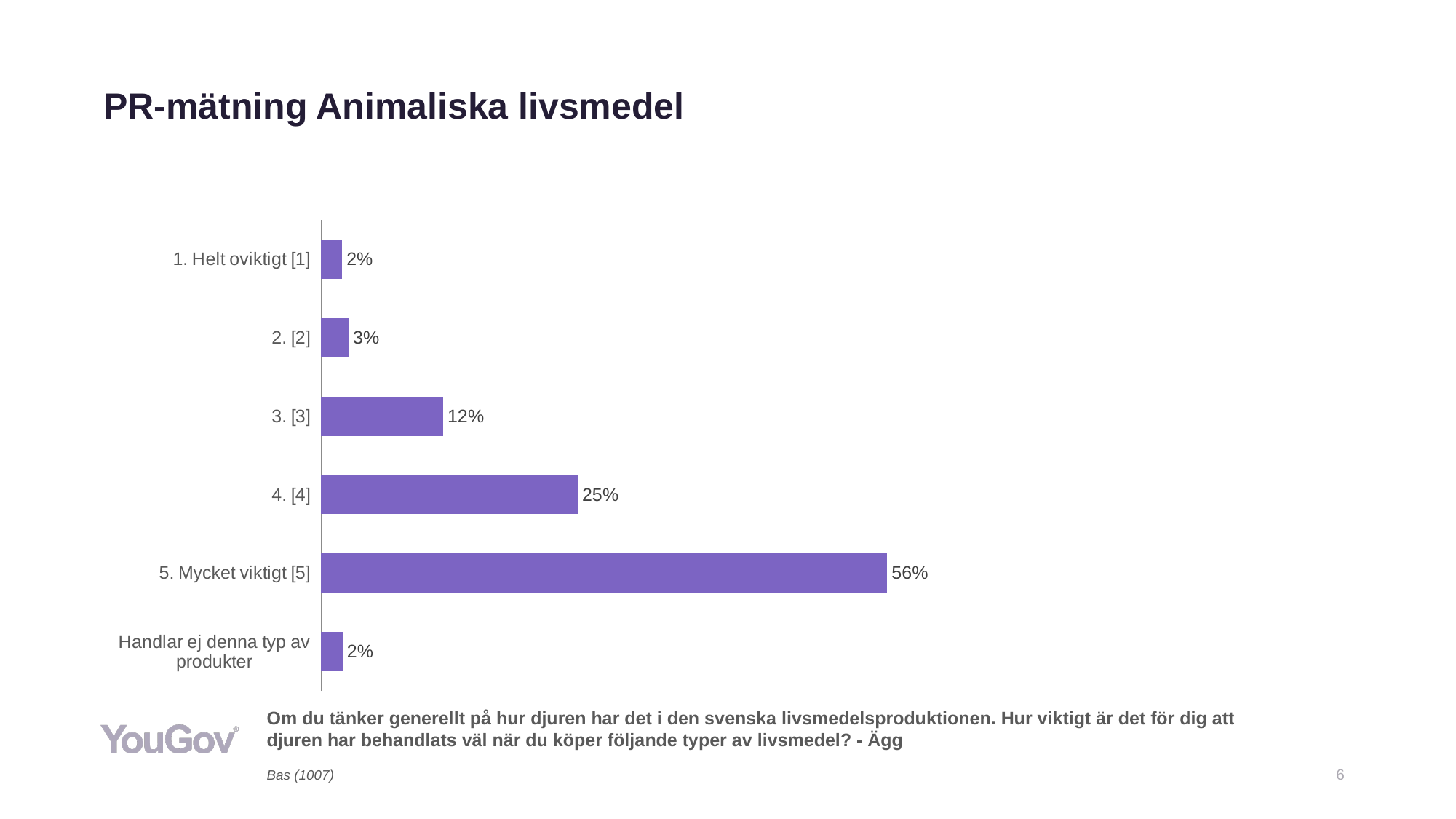
What is the value for "4. [4]"? 25% What is the combined value of "1. Helt oviktigt [1]" and "Handlar ej denna typ av produkter"? 4% What is the value for "3. [3]"? 12% Which category has the highest value? 5. Mycket viktigt [5] How many categories are shown in the chart? 6 What kind of chart is shown on the slide? Bar chart What is the difference between the values for "5. Mycket viktigt [5]" and "4. [4]"? 31% What is the value for "5. Mycket viktigt [5]"? 56% Which is larger, the value for "3. [3]" or the value for "2. [2]"? 3. [3] What is the title of the slide? PR-mätning Animaliska livsmedel What is the difference between the values for "4. [4]" and "3. [3]"? 13% What is the value for "2. [2]"? 3%